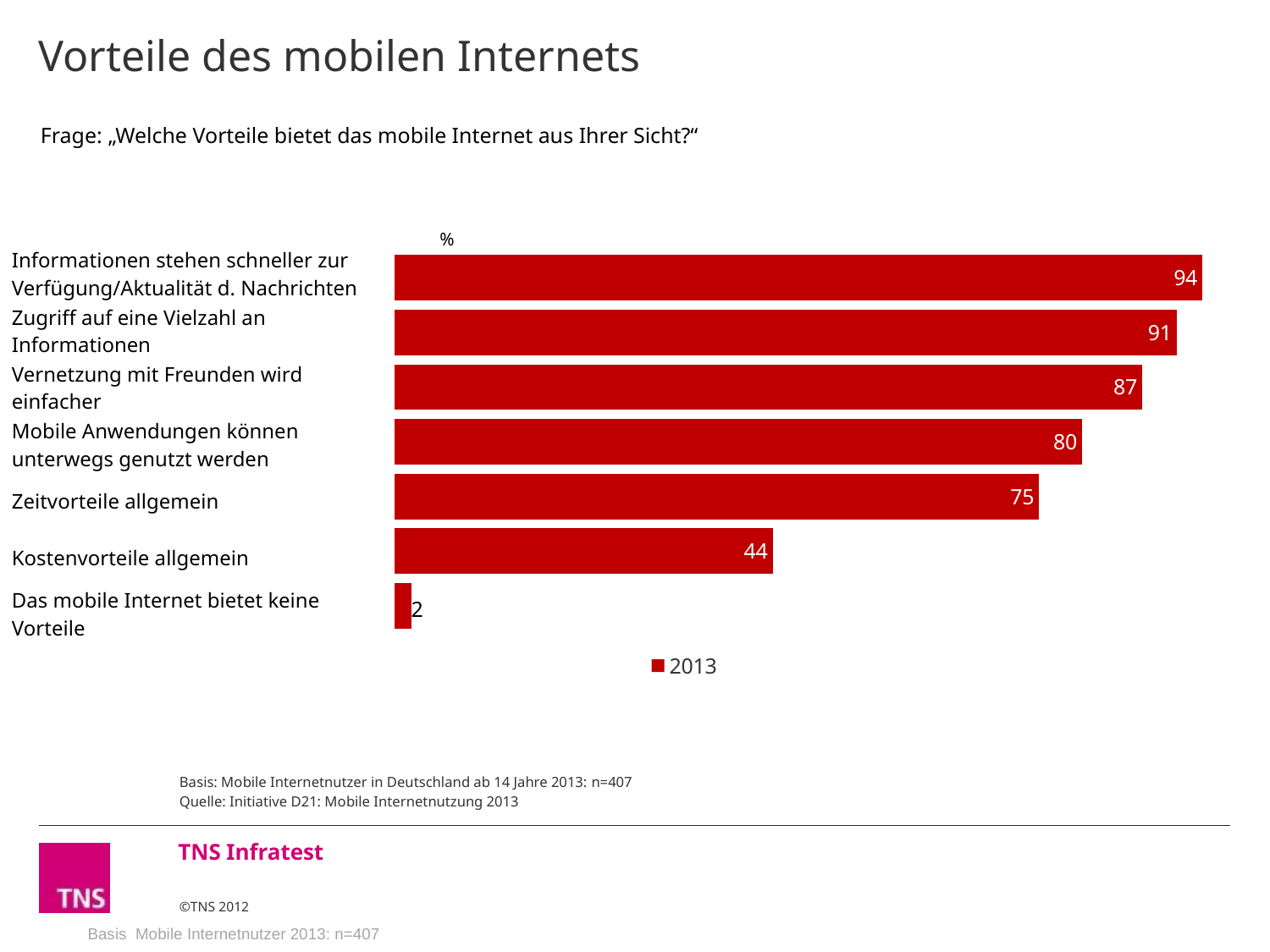
What is the difference between the highest and lowest values in the chart? 92 Which is larger: the value for "Zeitvorteile allgemein" or the value for "Kostenvorteile allgemein"? Zeitvorteile allgemein What is the value for "Zeitvorteile allgemein"? 75 What is the difference between the values for "Zugriff auf eine Vielzahl an Informationen" and "Mobile Anwendungen können unterwegs genutzt werden"? 11 How many series does the legend list? 1 Which category has the highest value? Informationen stehen schneller zur Verfügung/Aktualität d. Nachrichten How many categories are shown in the chart? 7 What kind of chart is shown on the slide? Bar chart What is the value for "Vernetzung mit Freunden wird einfacher"? 87 What is the value for "Kostenvorteile allgemein"? 44 Which category has the lowest value? Das mobile Internet bietet keine Vorteile What series name is shown in the legend? 2013